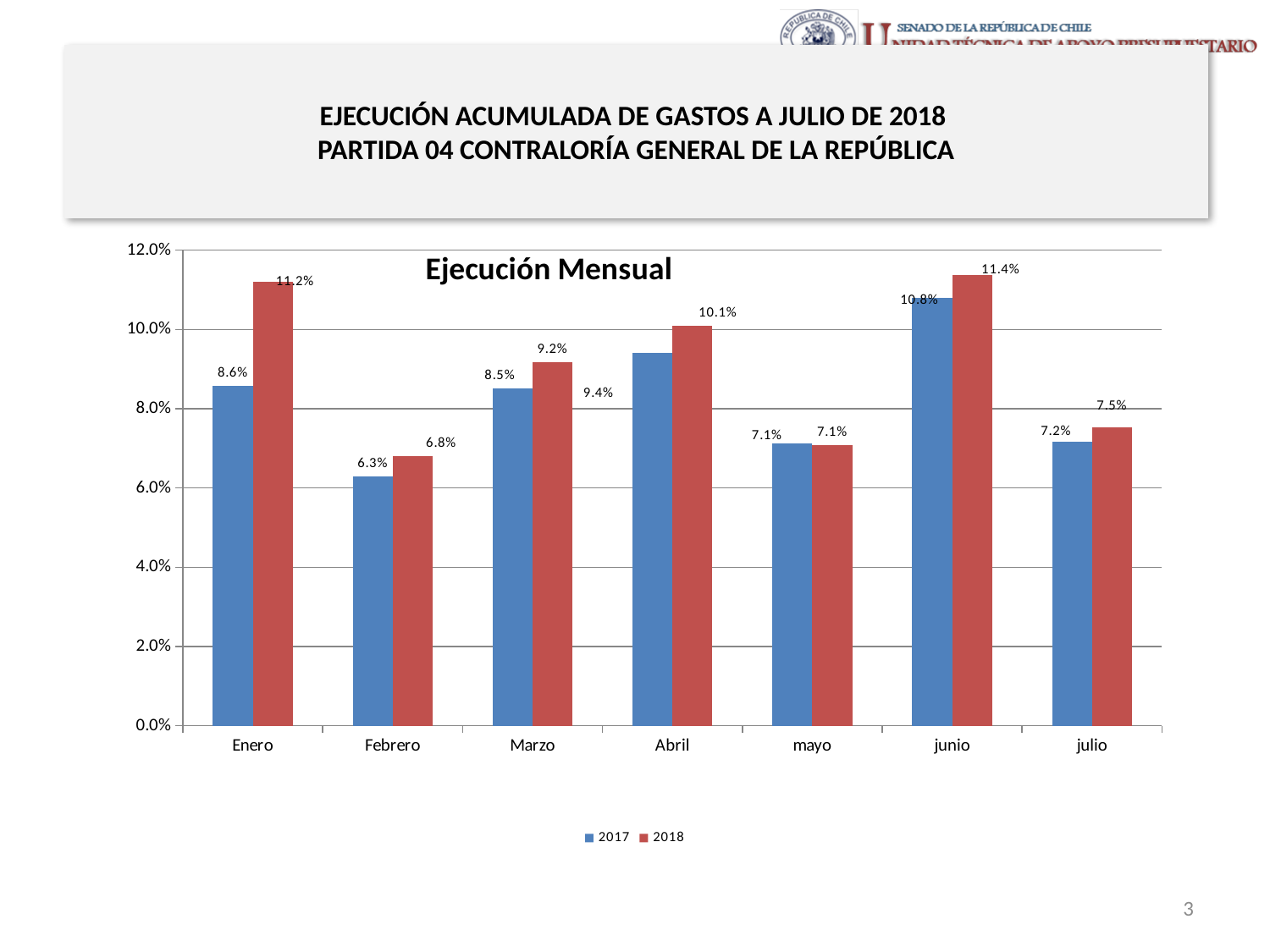
How many series does the legend list? 2 Which is larger in Marzo, the 2017 value or the 2018 value? 2018 What is the value for 2018 in junio? 11.4% What is the value for 2017 in julio? 7.2% How many months are shown on the x axis? 7 What kind of chart is shown on the slide? bar chart What is the value for 2018 in Enero? 11.2% Which month has the lowest value for the 2017 series? Febrero What is the value for 2017 in Febrero? 6.3% What is the difference between the 2018 and 2017 values in Enero? 2.6% Which month has the highest value for the 2018 series? junio Is the value for 2017 in junio greater or less than 10.0%? greater